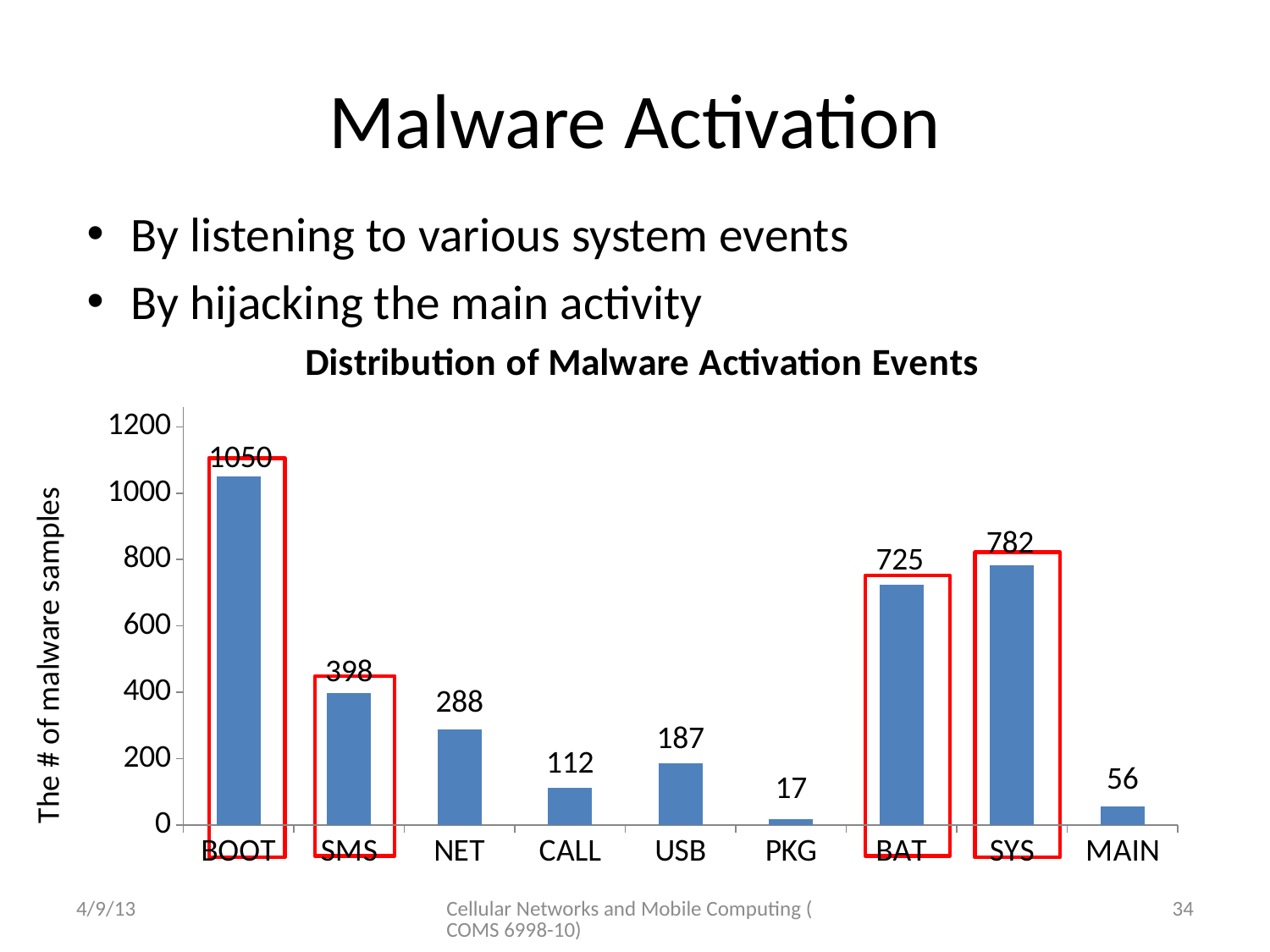
What is the value for BAT? 725 What is the difference between the values for SYS and BAT? 57 What is the value for BOOT in the Distribution of Malware Activation Events chart? 1050 Which category has the highest number of malware samples? BOOT Which is larger, the value for SMS or the value for NET? SMS What is the label of the y axis? The # of malware samples What is the title of the chart? Distribution of Malware Activation Events How many categories are shown on the x axis? 9 What kind of chart is shown on the slide? bar chart What is the value for PKG? 17 Which category has the lowest number of malware samples? PKG Is the value for USB greater or less than 200? less